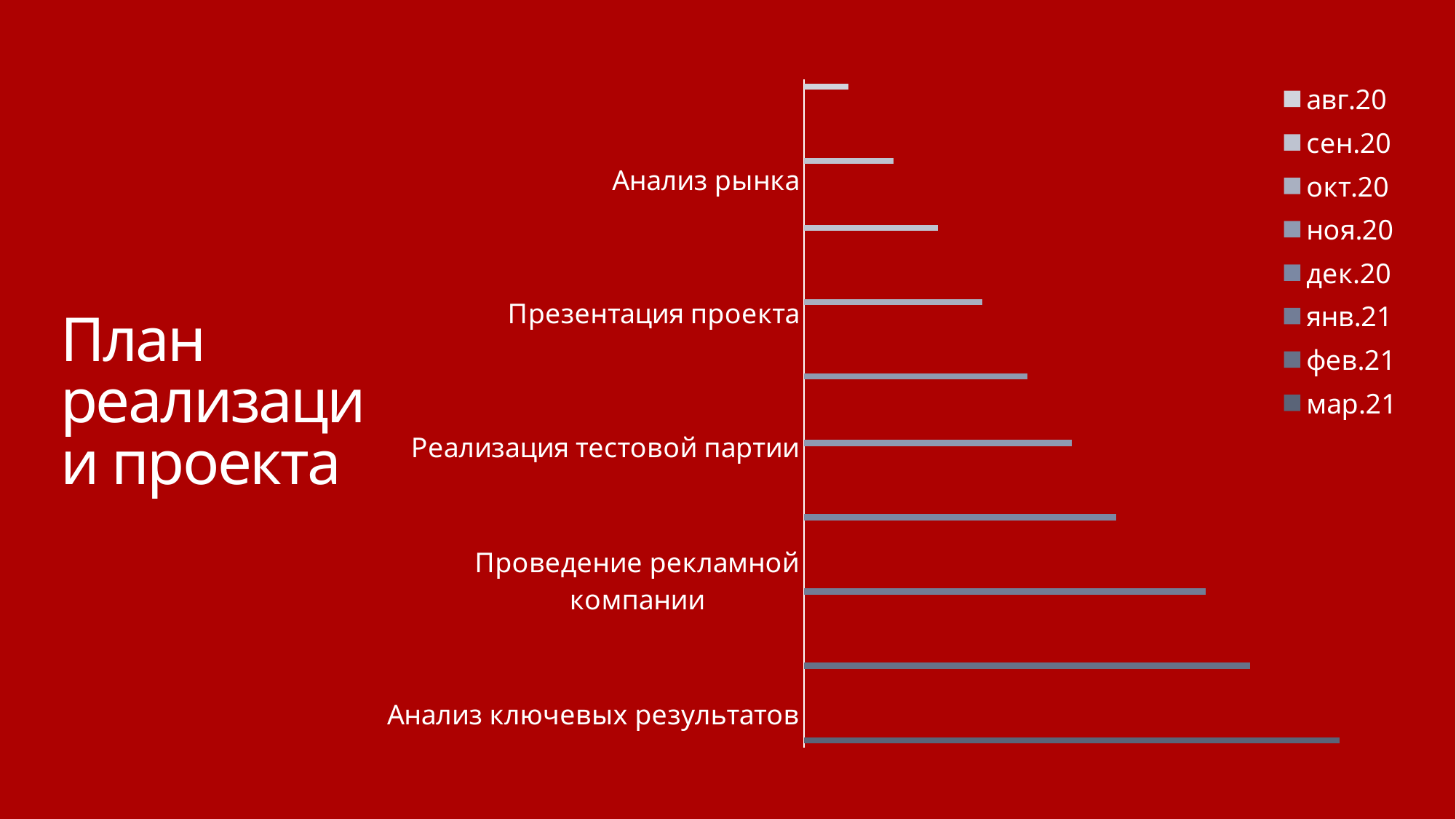
Do the bars get longer or shorter going from the top of the chart to the bottom? longer What is the first entry in the chart legend? авг.20 How many bars are plotted in the chart? 10 Which category label is next to the longest bar in the chart? Анализ ключевых результатов Which bar is longer: the one next to "Презентация проекта" or the one next to "Реализация тестовой партии"? Реализация тестовой партии What kind of chart is shown on the slide? bar chart Which bar is longer: the one next to "Анализ рынка" or the one next to "Проведение рекламной компании"? Проведение рекламной компании How many series does the chart legend list? 8 How many category labels are shown along the vertical axis of the chart? 5 What is the last entry in the chart legend? мар.21